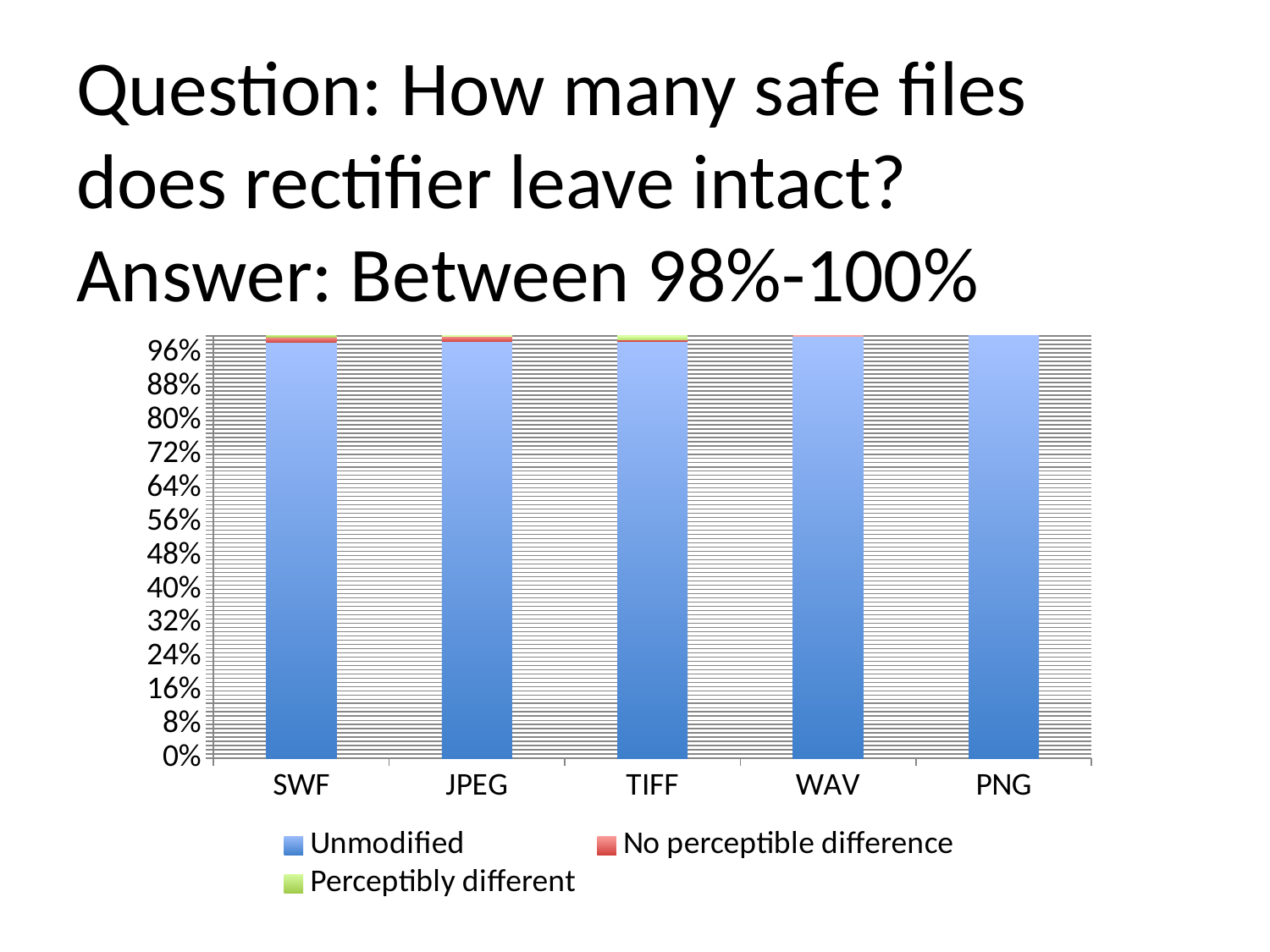
Which file formats are listed along the x axis of the chart? SWF, JPEG, TIFF, WAV, PNG Is the Unmodified value for WAV greater or less than 88%? greater Is the Unmodified value for PNG greater or less than 96%? greater Is the Perceptibly different value for TIFF greater or less than 8%? less How many series does the chart's legend list? 3 How many file-format categories are shown on the x axis of the chart? 5 What kind of chart is shown on the slide? stacked bar chart What are the three series named in the chart's legend? Unmodified, No perceptible difference, Perceptibly different